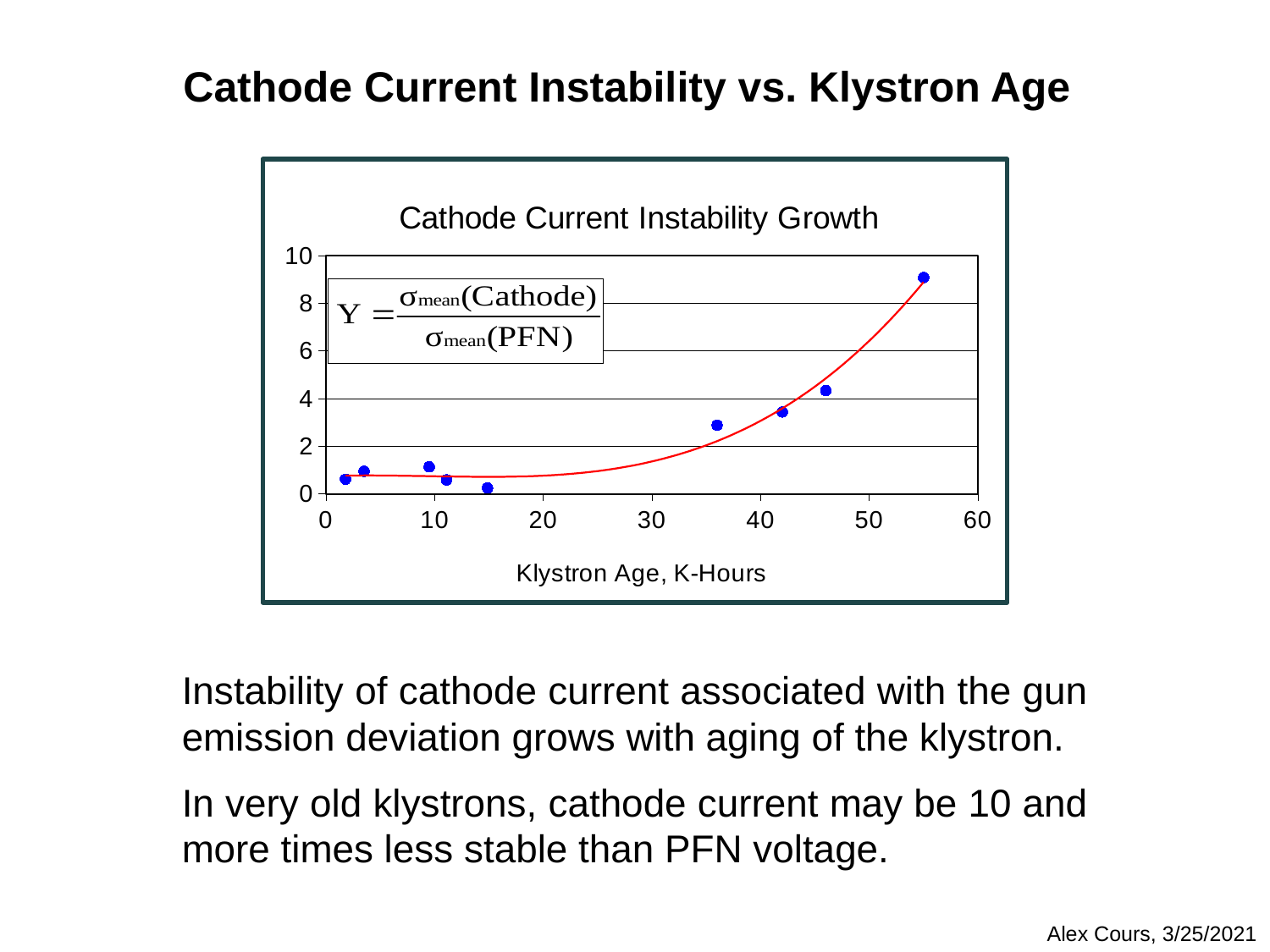
How many data points are plotted on the chart? 9 Are all data points with Klystron Age below 20 K-Hours greater or less than 2? less What is the title of the chart? Cathode Current Instability Growth What is the label of the x axis of the chart? Klystron Age, K-Hours Is the value of the highest data point greater or less than 6? greater Is the value of the leftmost data point greater or less than 2? less What kind of chart is shown on the slide? scatter chart What is the maximum value shown on the y axis of the chart? 10 Do the plotted values generally rise or fall as Klystron Age increases? rise Is the rightmost data point higher or lower than the leftmost data point? higher